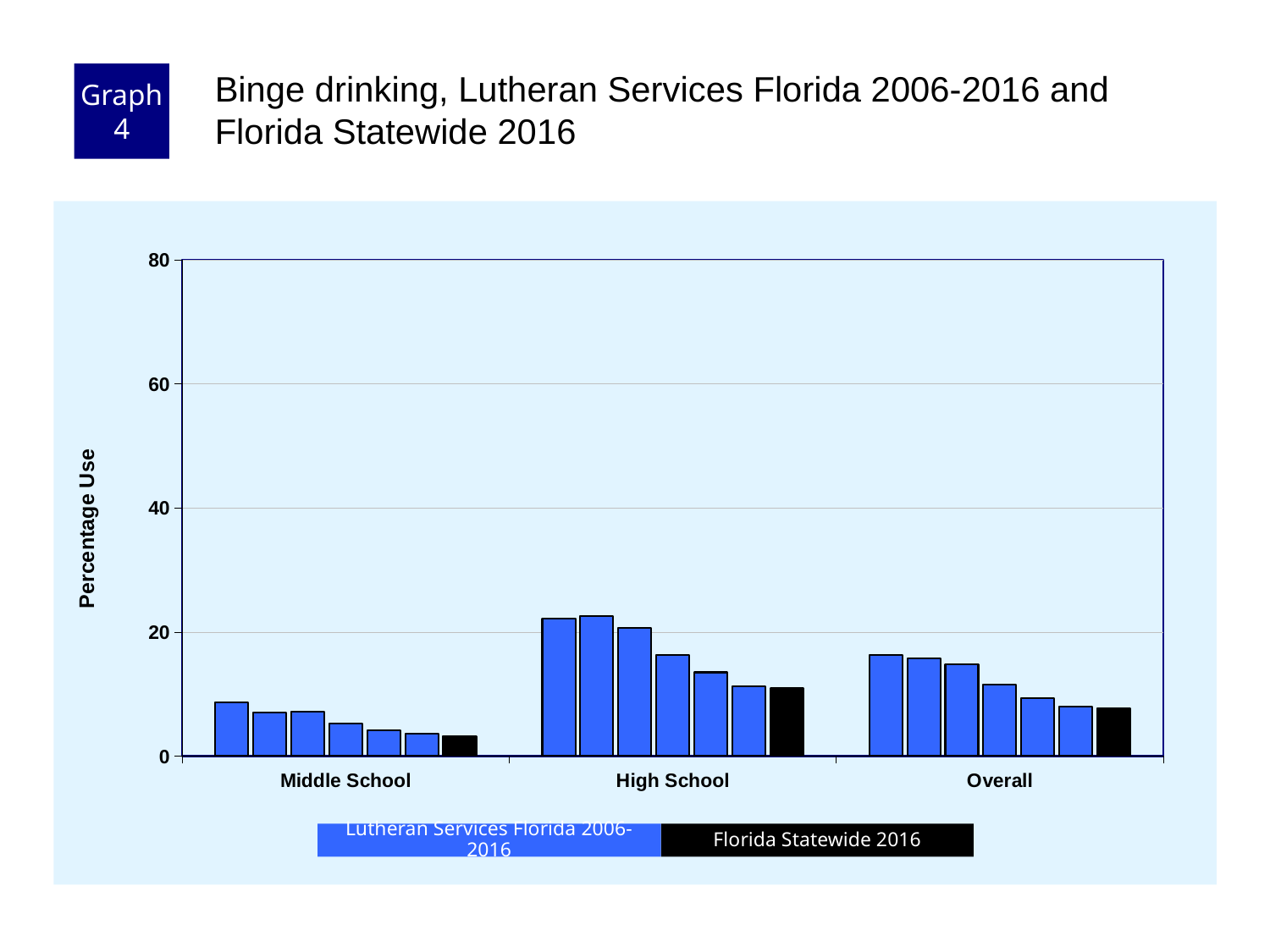
How many series does the legend list? 2 Are the bars for High School higher or lower than the bars for Middle School? higher Which category has the lowest bars? Middle School Is the highest High School bar greater or less than 40? less Within the High School group, do the Lutheran Services Florida bars rise or fall from left to right? fall What colour are the Florida Statewide 2016 bars? black What kind of chart is shown on the slide? bar chart Is the Florida Statewide 2016 value for Overall greater or less than 20? less What is the label on the y axis? Percentage Use How many categories are shown on the x axis? 3 Which category has the highest bars? High School Is the Florida Statewide 2016 value for Middle School greater or less than 20? less